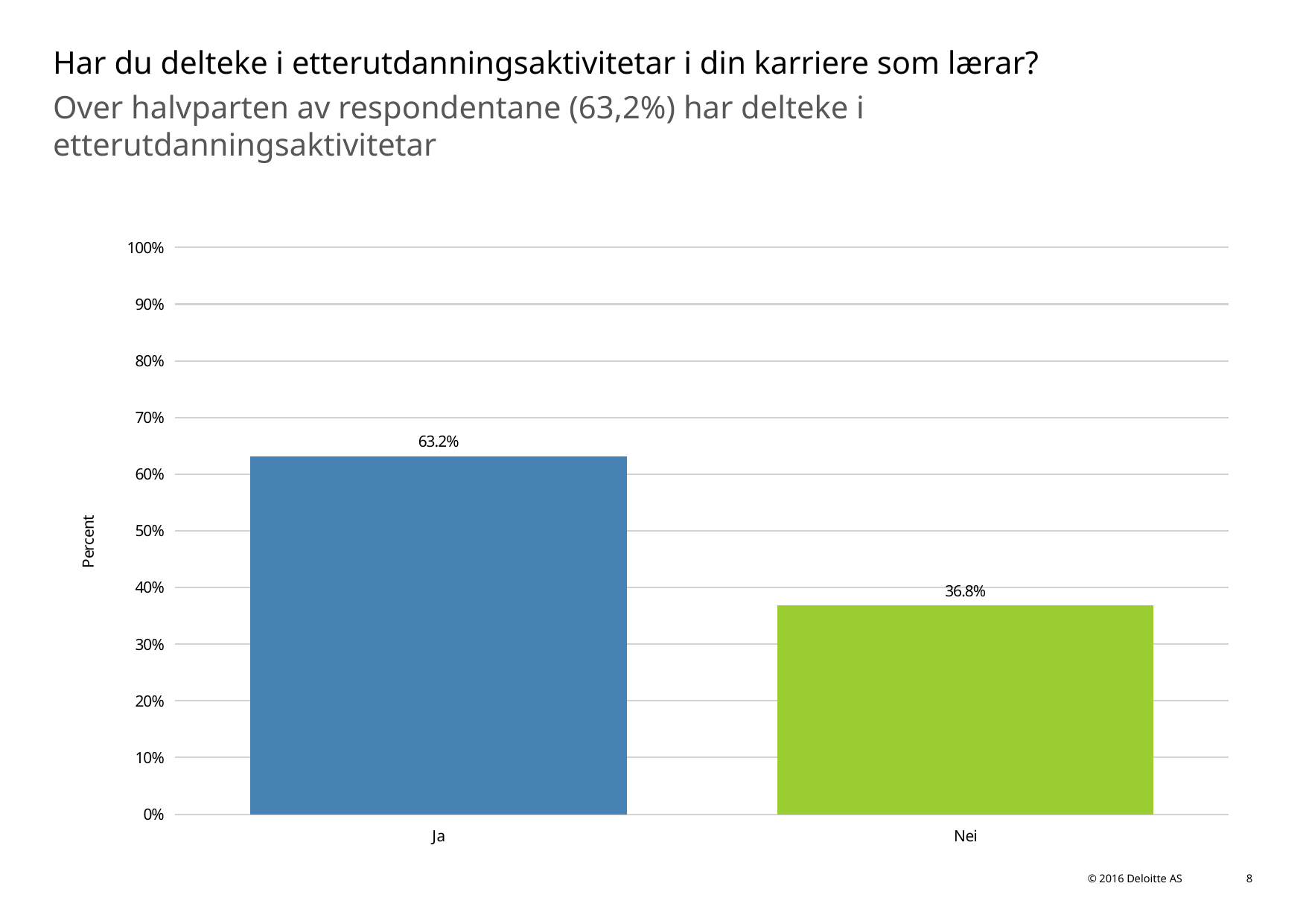
What is the label of the y axis? Percent What is the difference between the values for Ja and Nei? 26.4% Which is larger, the value for Ja or the value for Nei? Ja What is the value for Ja? 63.2% What kind of chart is shown on the slide? bar chart How many categories are shown on the x axis? 2 Which category has the lowest value? Nei What is the value for Nei? 36.8% Which category has the highest value? Ja Is the value for Nei greater or less than 40%? less Is the value for Ja greater or less than 60%? greater What colour is the bar for Nei? green